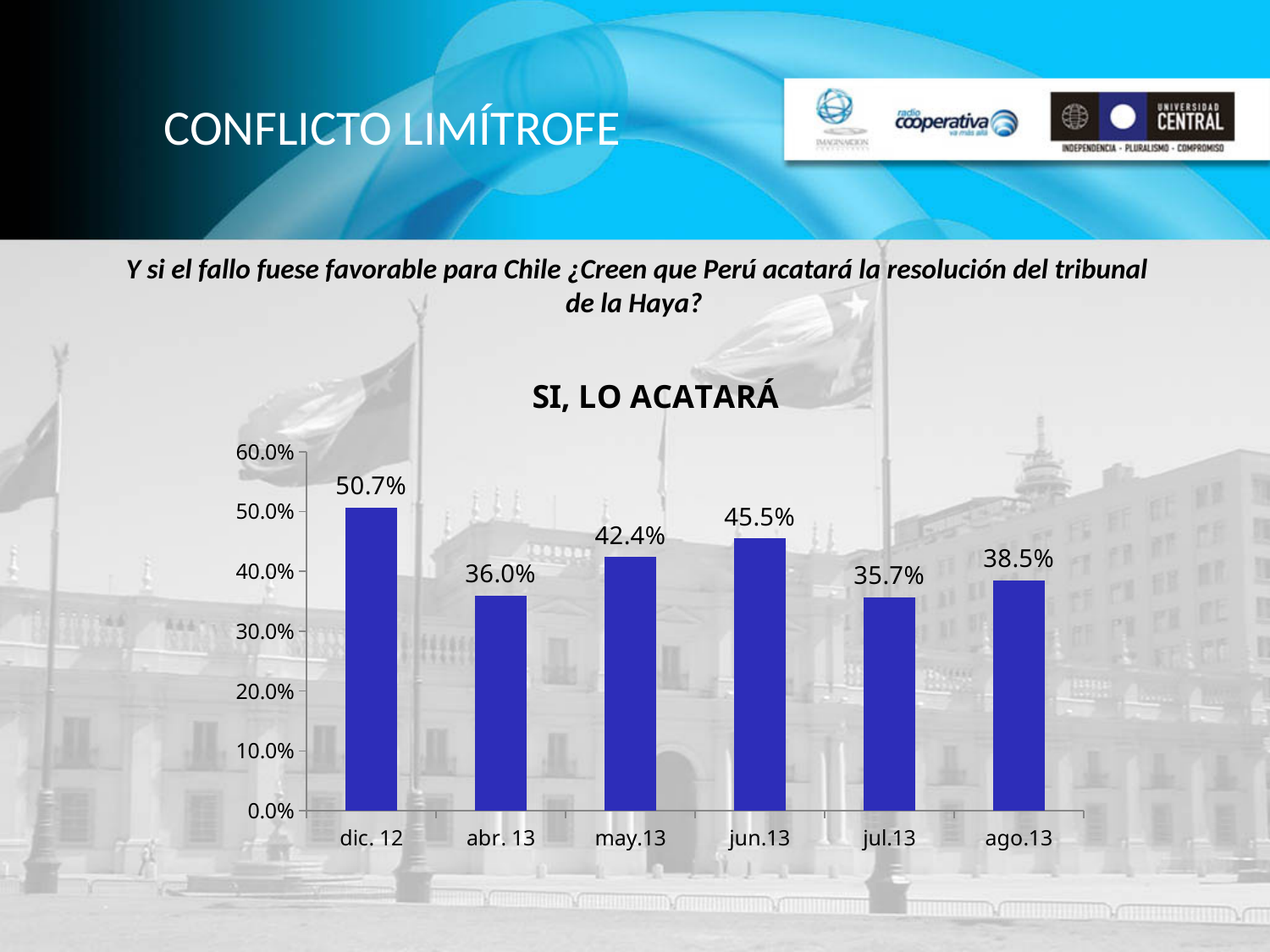
What is the value for jul.13? 35.7% What is the difference between the values for jun.13 and may.13? 3.1% What is the difference between the values for dic. 12 and abr. 13? 14.7% How many months are shown on the x axis? 6 What kind of chart is shown on the slide? bar chart Which month has the highest value? dic. 12 Which is larger, the value for may.13 or the value for ago.13? may.13 Which month has the lowest value? jul.13 Is the value for jun.13 greater or less than 40.0%? greater What is the value for dic. 12? 50.7% What is the title of the chart? SI, LO ACATARÁ What is the value for ago.13? 38.5%